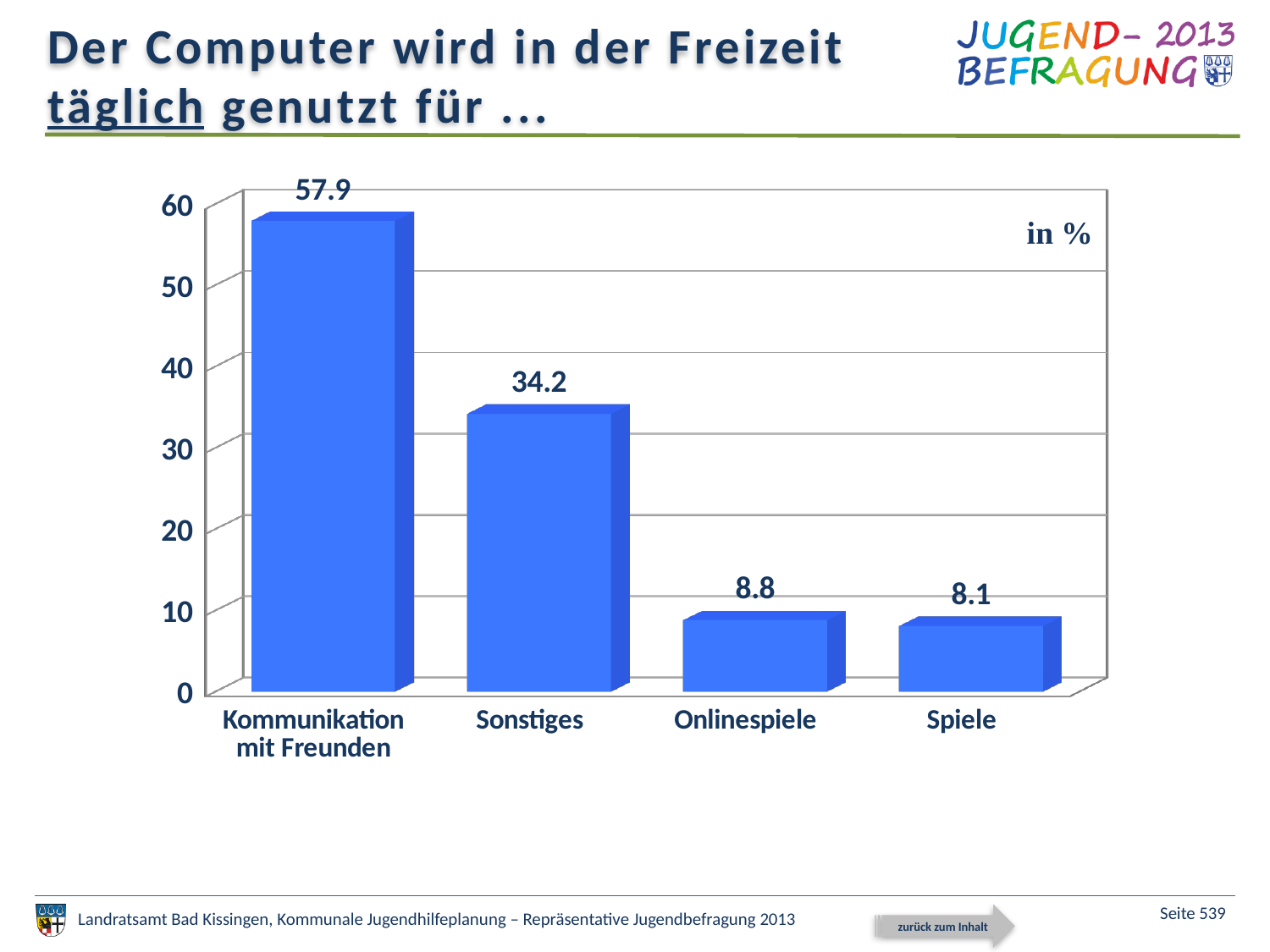
Which is larger, the value for Sonstiges or the value for Onlinespiele? Sonstiges What kind of chart is shown on the slide? bar chart What is the difference between the values for Kommunikation mit Freunden and Sonstiges? 23.7 What is the value for Onlinespiele? 8.8 What is the value for Kommunikation mit Freunden? 57.9 Which category has the lowest value? Spiele What is the difference between the values for Onlinespiele and Spiele? 0.7 How many categories are shown in the chart? 4 Which category has the highest value? Kommunikation mit Freunden Is the value for Sonstiges greater or less than 30? greater What is the value for Spiele? 8.1 What is the value for Sonstiges? 34.2